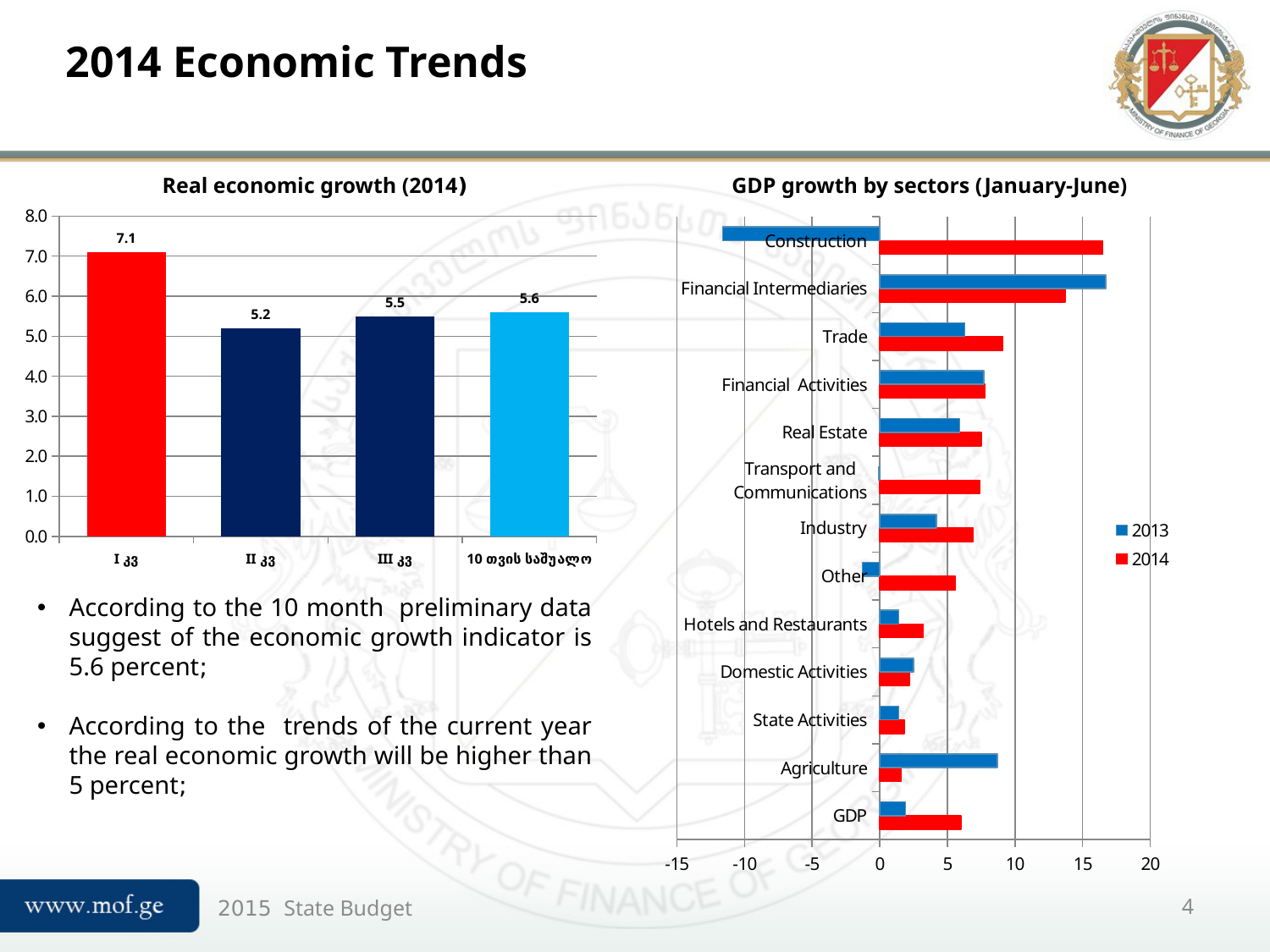
How many bars are plotted in the 'Real economic growth (2014)' chart? 4 In the 'Real economic growth (2014)' chart, what is the value for the first quarter (I კვ)? 7.1 How many series does the legend of the 'GDP growth by sectors (January-June)' chart list? 2 In the 'Real economic growth (2014)' chart, which bar has the lowest value? II კვ (second quarter) In the 'Real economic growth (2014)' chart, which bar has the highest value? I კვ (first quarter) What kind of chart is 'Real economic growth (2014)'? Bar chart In the 'Real economic growth (2014)' chart, what is the value for the 10-month average (10 თვის საშუალო)? 5.6 In the 'GDP growth by sectors (January-June)' chart, is the 2013 value for Construction greater or less than -10? less In the 'GDP growth by sectors (January-June)' chart, is the 2014 value for Construction greater or less than 15? greater In the 'GDP growth by sectors (January-June)' chart, which year has the larger value for Agriculture, 2013 or 2014? 2013 In the 'Real economic growth (2014)' chart, what is the difference between the first quarter (7.1) and the second quarter (5.2)? 1.9 How many sector categories are shown in the 'GDP growth by sectors (January-June)' chart? 13